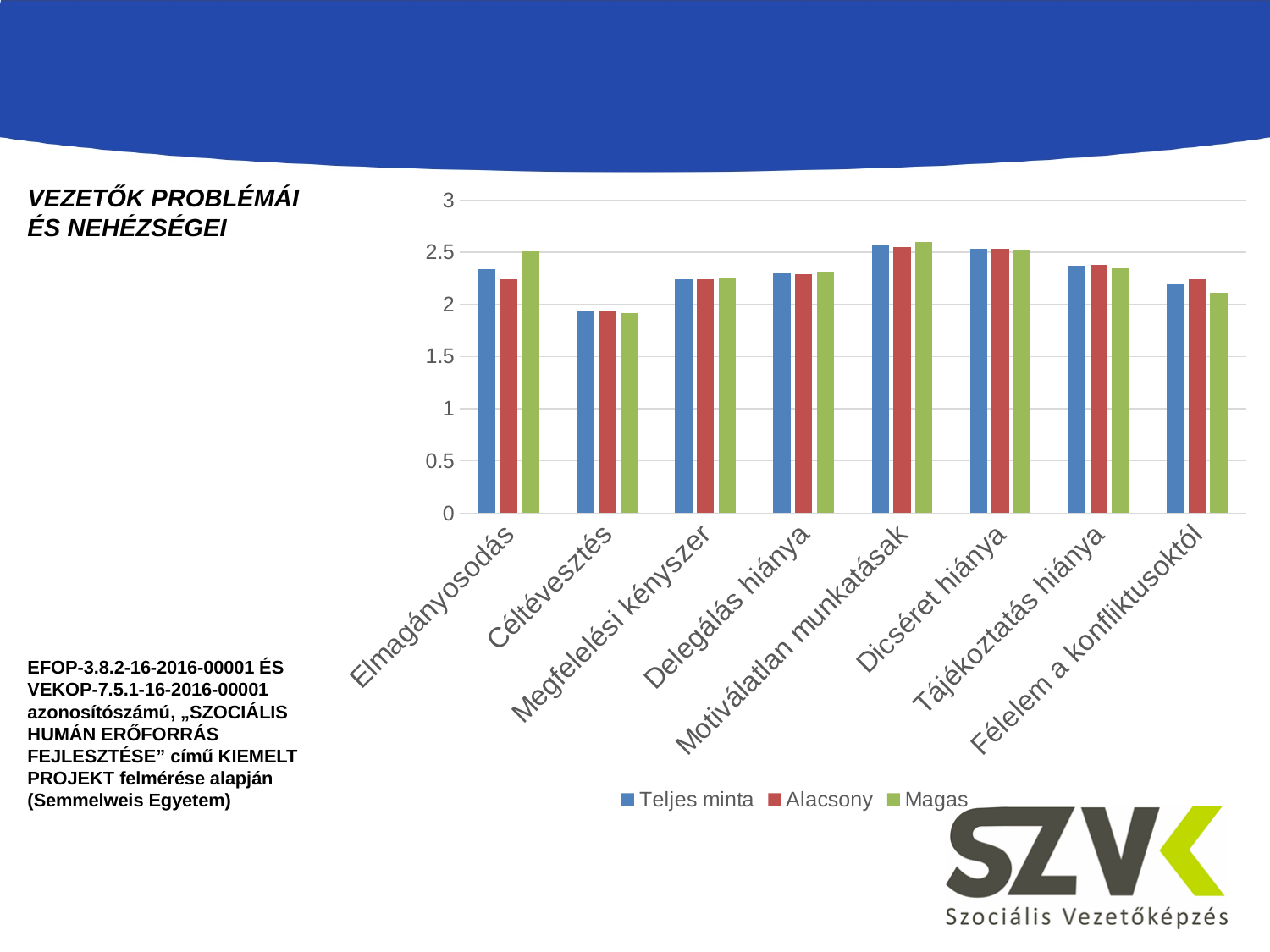
How many series does the chart legend list? 3 How many categories are shown on the x axis of the chart? 8 Which series is shown in green in the chart? Magas What is the first series listed in the chart legend? Teljes minta Is the Teljes minta value for Céltévesztés greater or less than 2? less What kind of chart is shown on the slide? bar chart Is the Magas value for Motiválatlan munkatársak greater or less than 2.5? greater Is the Teljes minta value for Tájékoztatás hiánya greater or less than 2.5? less Which is larger, the Teljes minta value for Elmagányosodás or for Céltévesztés? Elmagányosodás Which is larger, the Magas value for Elmagányosodás or for Félelem a konfliktusoktól? Elmagányosodás Which category has the lowest values in the chart? Céltévesztés